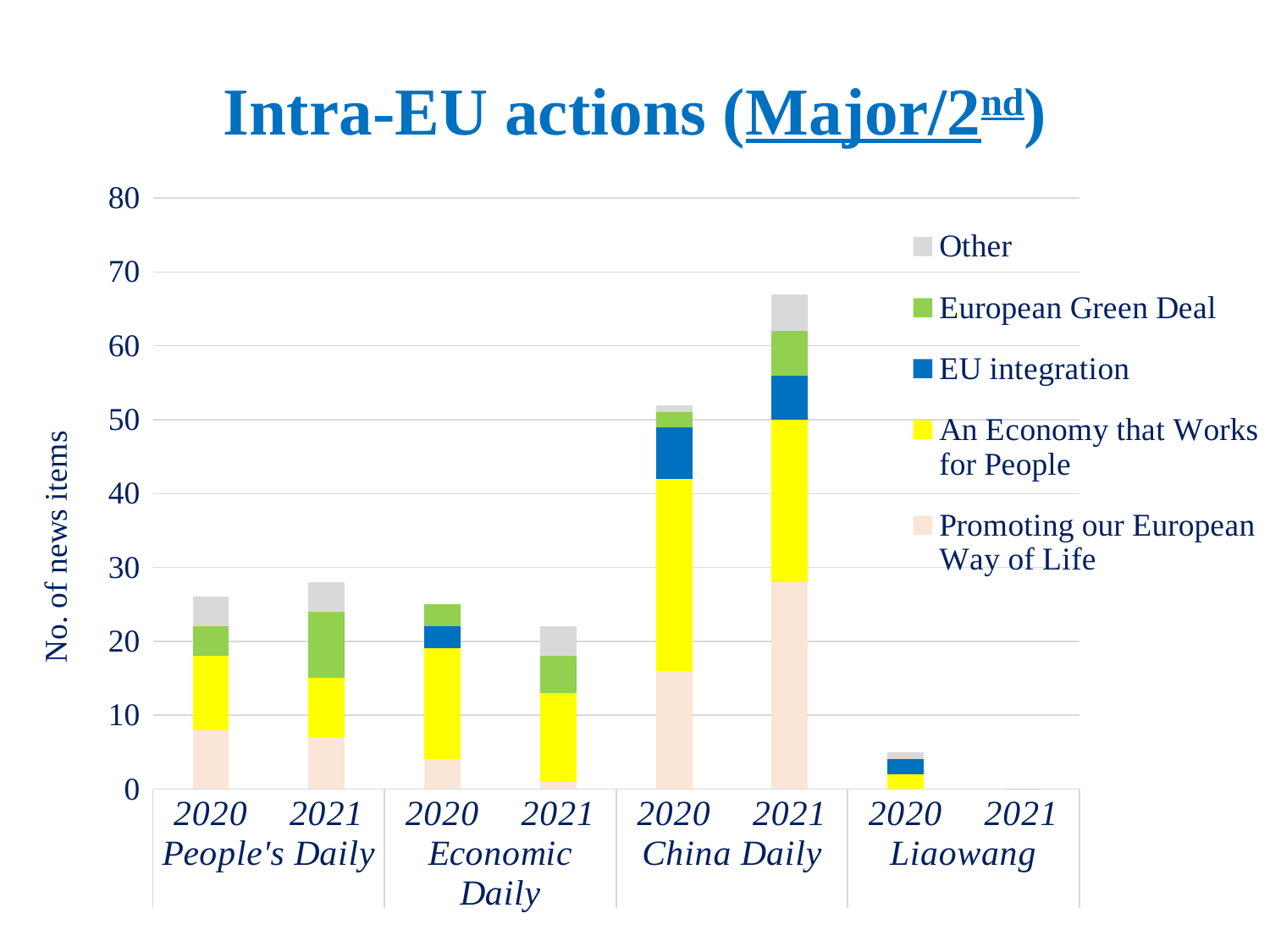
Did the total for China Daily rise or fall from 2020 to 2021? Rise What kind of chart is shown on the slide? Stacked bar chart How many series does the legend list? 5 Is the total for China Daily 2021 greater or less than 60? greater Which bar has the highest total number of news items? China Daily 2021 Which bar has the lowest total number of news items? Liaowang 2021 Which is larger, the total for China Daily 2020 or China Daily 2021? China Daily 2021 Is the total for Liaowang 2020 greater or less than 10? less Is the total for China Daily 2020 greater or less than 40? greater What is the label on the vertical axis? No. of news items